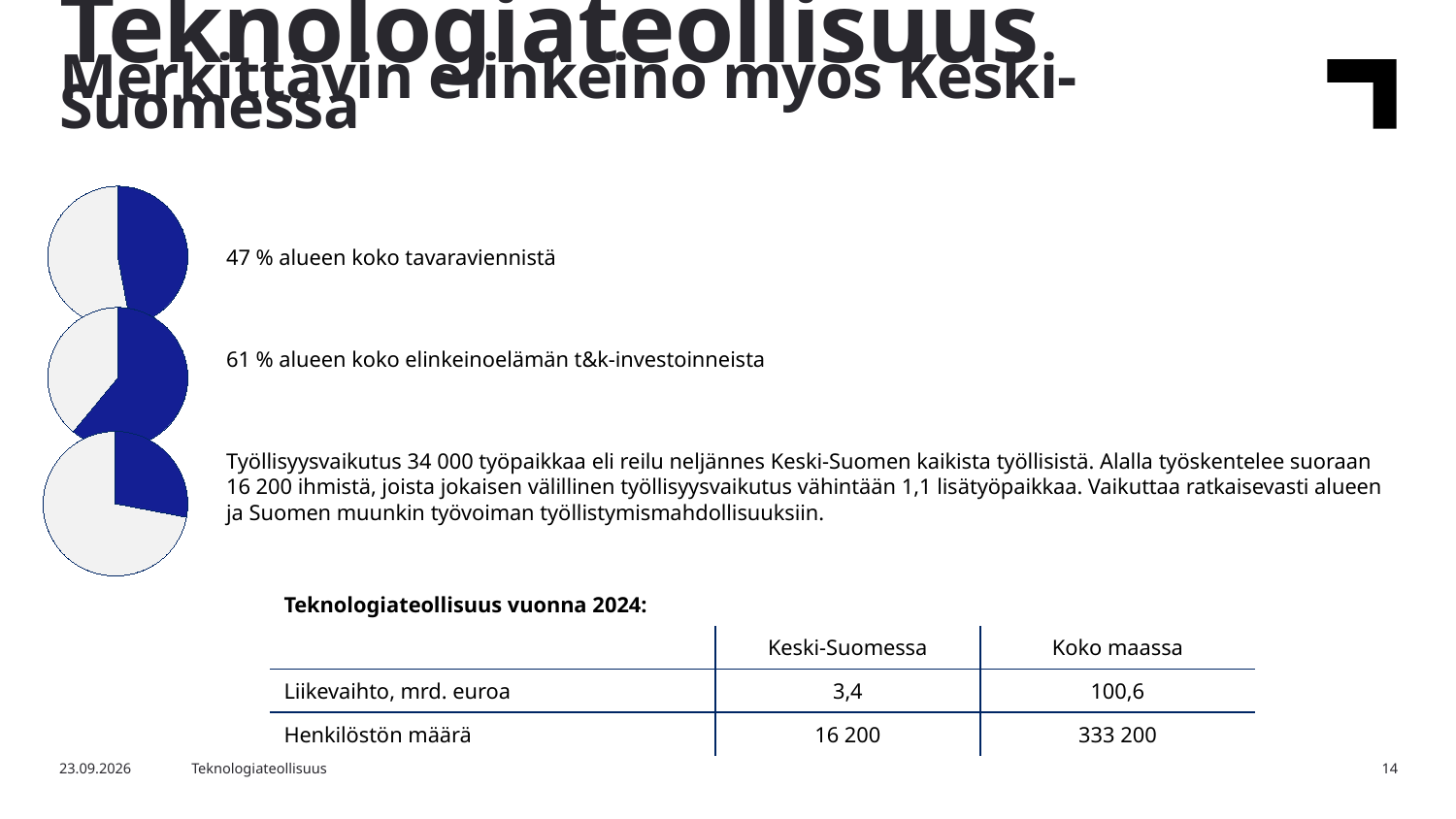
In the middle pie chart, what share of the region's business R&D investments does the blue slice represent? 61 % How many pie charts are on the slide? 3 Which of the three pie charts has the largest blue slice? The middle one Is the blue slice in the top pie chart greater or less than 50 % of the pie? less Which pie chart has the larger blue slice, the top one or the middle one? The middle one Is the blue slice in the middle pie chart greater or less than 50 % of the pie? greater Which of the three pie charts has the smallest blue slice? The bottom one What kind of charts are shown on the left side of the slide? Pie charts In the top pie chart, what share of the region's total goods exports does the blue slice represent? 47 % How many slices does each pie chart have? 2 What colour is the highlighted slice in each pie chart? Blue Is the blue slice in the bottom pie chart greater or less than 50 % of the pie? less